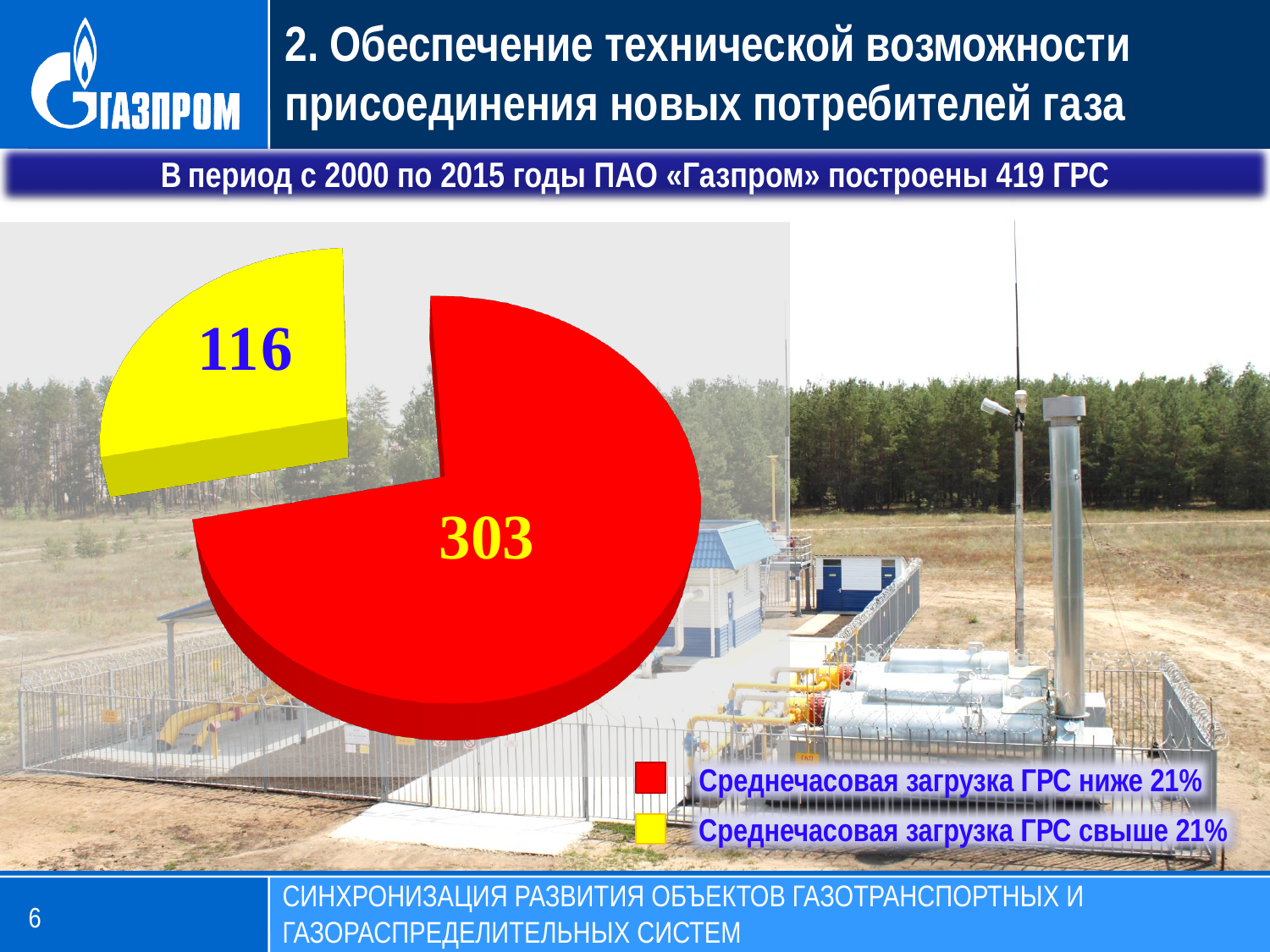
What is the value of the slice for 'Среднечасовая загрузка ГРС свыше 21%'? 116 What is the difference between the values of the red slice and the yellow slice? 187 Which category has the largest slice in the pie chart? Среднечасовая загрузка ГРС ниже 21% What share of the pie does the slice for 'Среднечасовая загрузка ГРС свыше 21%' represent? 27.7% How many slices does the pie chart have? 2 Which category has the smallest slice in the pie chart? Среднечасовая загрузка ГРС свыше 21% What colour is the slice for 'Среднечасовая загрузка ГРС ниже 21%'? red What is the value of the slice for 'Среднечасовая загрузка ГРС ниже 21%'? 303 What type of chart is shown on the slide? pie chart Which is larger: the slice for 'ниже 21%' or the slice for 'свыше 21%'? ниже 21% How many entries does the legend list? 2 What is the total of the two slices in the pie chart? 419